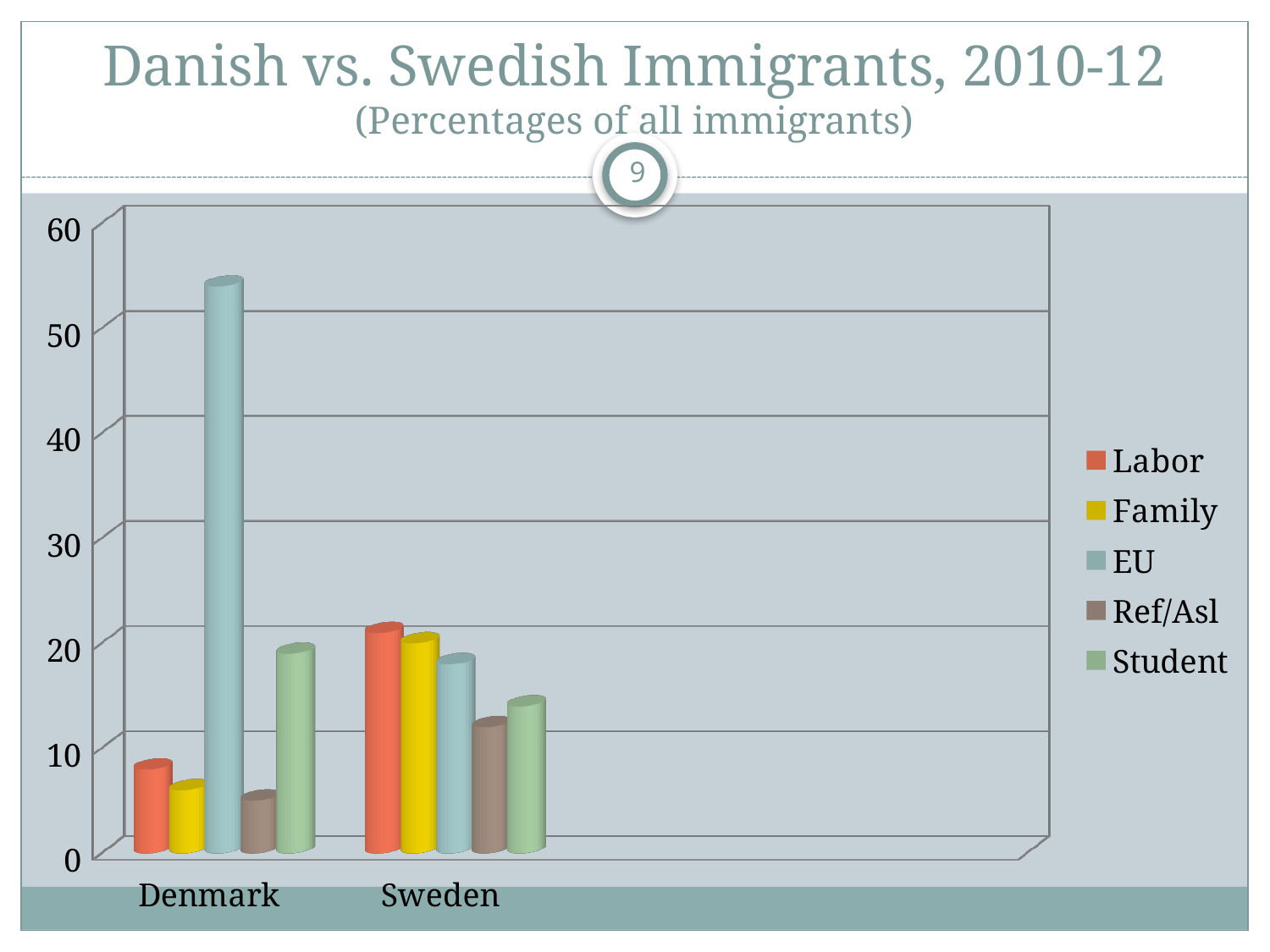
Is the Labor value for Denmark greater or less than 10? less Which country has the larger EU value, Denmark or Sweden? Denmark Which series has the lowest value for Denmark? Ref/Asl Is the Student value for Sweden greater or less than 20? less What is the title of the chart? Danish vs. Swedish Immigrants, 2010-12 (Percentages of all immigrants) Which series has the lowest value for Sweden? Ref/Asl What kind of chart is shown on the slide? Bar chart Is the EU value for Denmark greater or less than 50? greater How many countries are shown on the x axis? 2 Which series has the highest value for Denmark? EU Which country has the larger Labor value, Denmark or Sweden? Sweden How many series does the legend list? 5